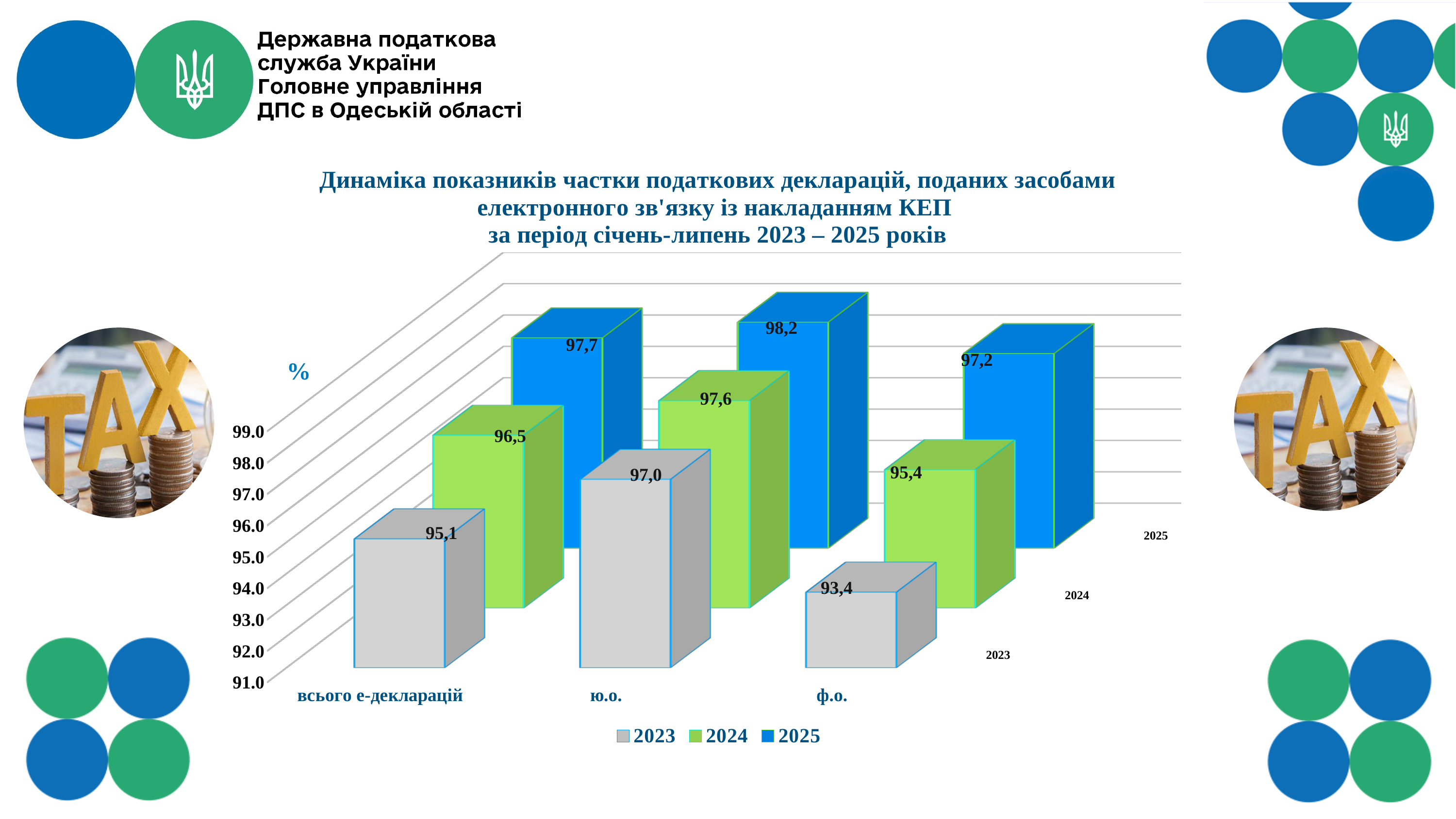
What is the difference between the 2025 and 2023 values for "ф.о."? 3,8 What is the value for 2023 in the category "ф.о."? 93,4 Do the values for "ю.о." rise or fall from 2023 to 2025? rise How many categories are shown on the x axis? 3 How many series does the legend list? 3 Which is larger: the 2024 value for "всього е-декларацій" or the 2024 value for "ю.о."? ю.о. What is the value for 2025 in the category "всього е-декларацій"? 97,7 Which colour represents the 2025 series in the legend? blue What is the value for 2024 in the category "ю.о."? 97,6 What kind of chart is shown on the slide? bar chart Which category has the lowest value for the 2023 series? ф.о. Which category has the highest value for the 2025 series? ю.о.